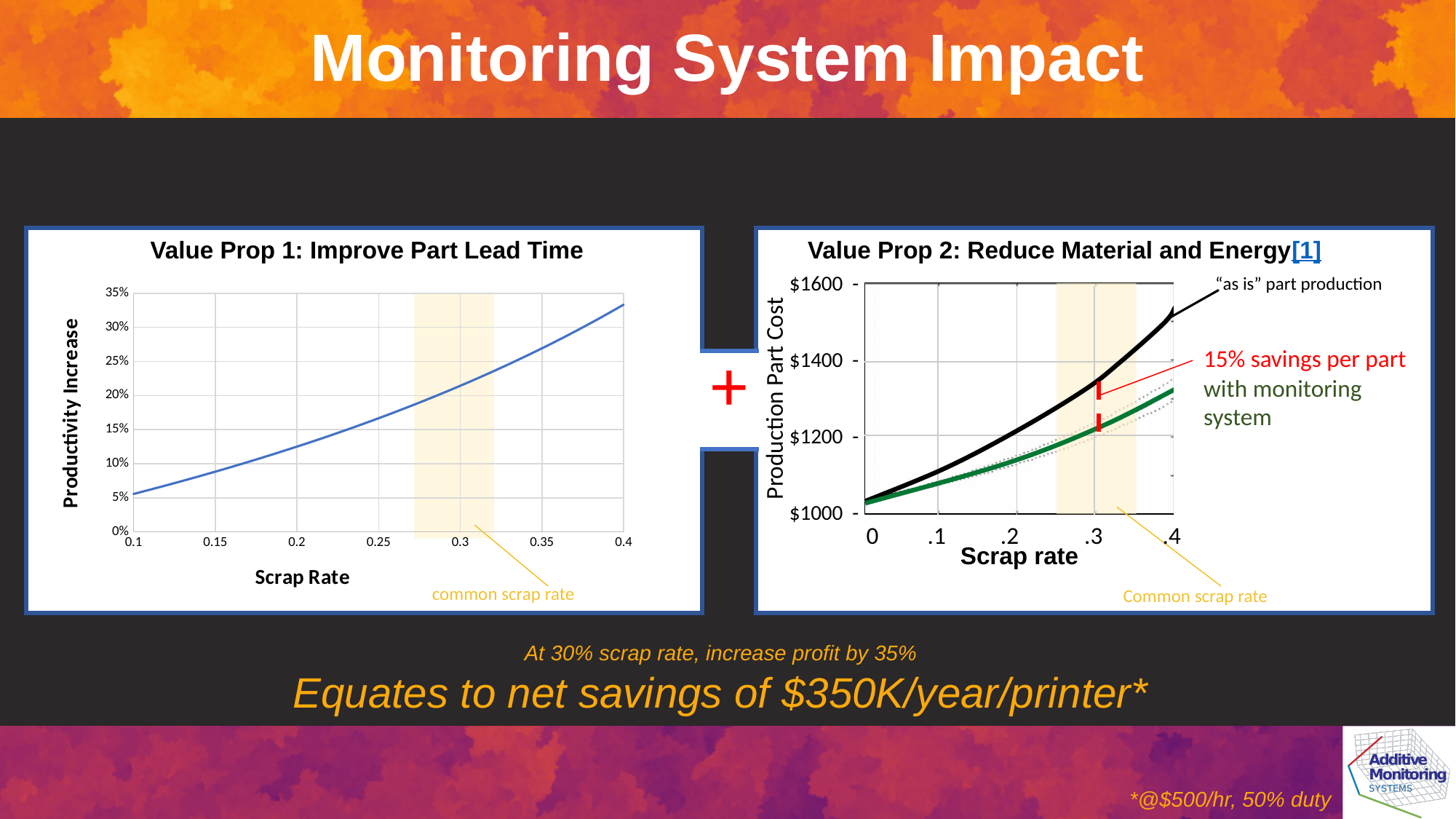
What kind of chart is "Value Prop 1: Improve Part Lead Time"? line chart In the "Value Prop 2: Reduce Material and Energy" chart, at a scrap rate of .3, which line shows the higher Production Part Cost: "as is" part production or with monitoring system? "as is" part production In the "Value Prop 1: Improve Part Lead Time" chart, is the Productivity Increase at a Scrap Rate of 0.2 greater or less than 10%? greater What is the x-axis label of the "Value Prop 1: Improve Part Lead Time" chart? Scrap Rate In the "Value Prop 1: Improve Part Lead Time" chart, does Productivity Increase rise or fall as Scrap Rate increases from 0.1 to 0.4? rise In the "Value Prop 2: Reduce Material and Energy" chart, is the cost with monitoring system at a scrap rate of .4 greater or less than $1400? less In the "Value Prop 1: Improve Part Lead Time" chart, is the Productivity Increase at a Scrap Rate of 0.1 greater or less than 10%? less What kind of chart is "Value Prop 2: Reduce Material and Energy"? line chart In the "Value Prop 2: Reduce Material and Energy" chart, does Production Part Cost rise or fall as scrap rate increases from 0 to .4? rise